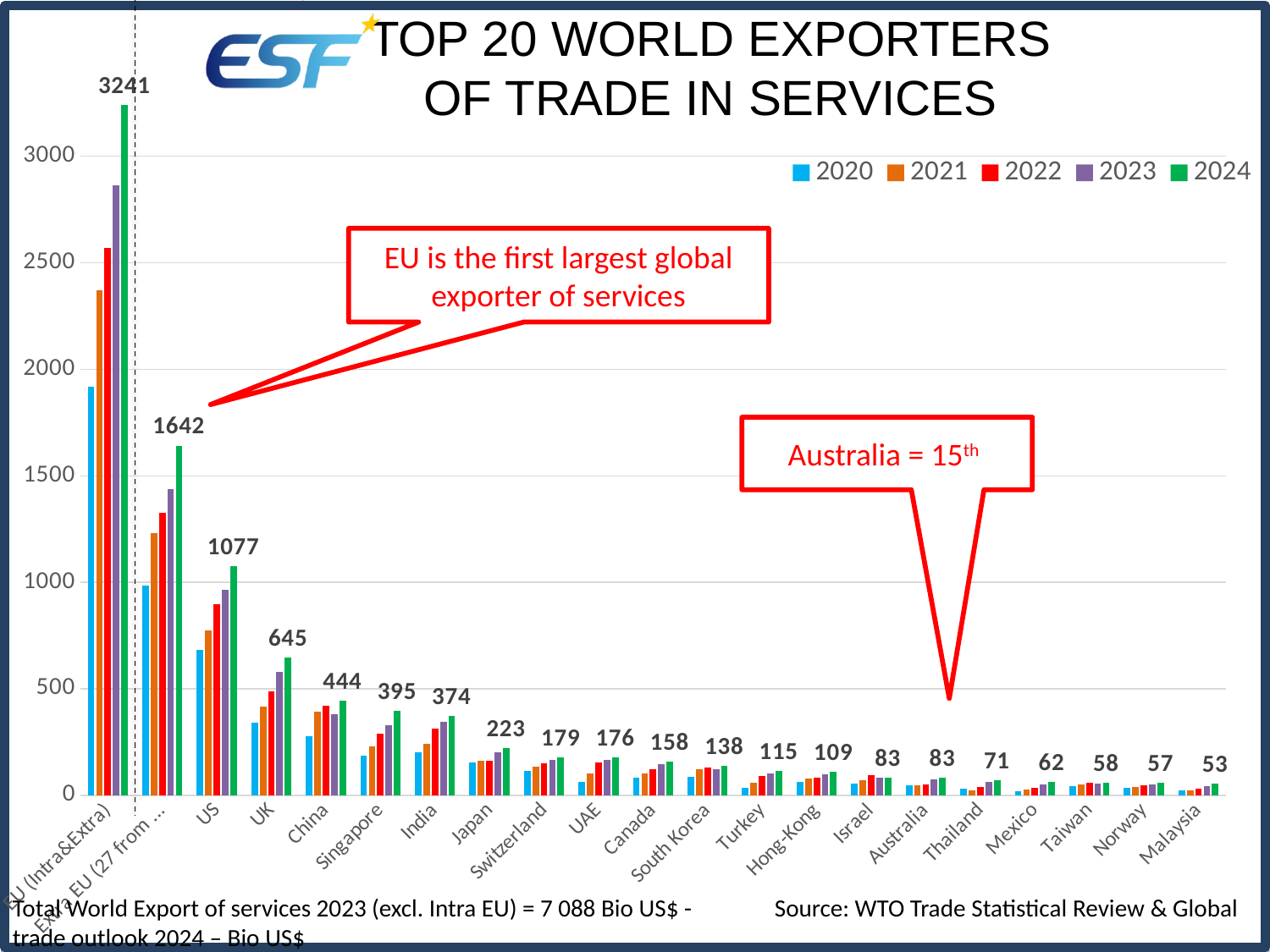
What is the 2024 value labelled for Malaysia? 53 What kind of chart is shown on the slide? bar chart Which category has the lowest 2024 value? Malaysia What is the 2024 value labelled for the US? 1077 Which years are listed in the legend? 2020, 2021, 2022, 2023, 2024 Which category has the highest 2024 value? EU (Intra&Extra) Is the 2020 value for EU (Intra&Extra) greater or less than 1500? greater What is the difference between the 2024 values for the US and the UK? 432 Do the values for the US rise or fall from 2020 to 2024? rise Which has the larger 2024 value, China or Singapore? China What is the 2024 value labelled for the UK? 645 How many series does the legend list? 5